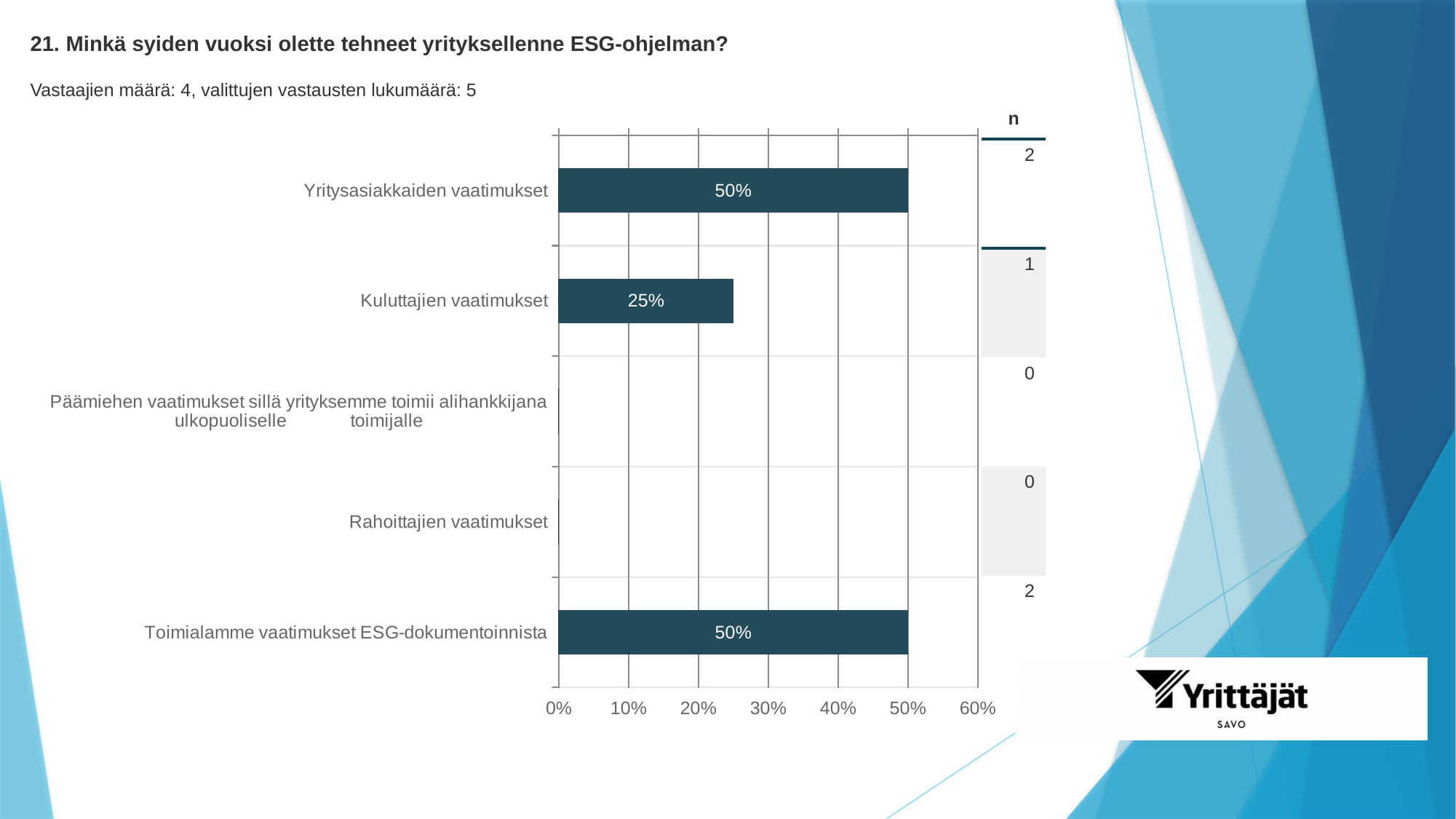
What percentage is shown for Toimialamme vaatimukset ESG-dokumentoinnista? 50% What is the n value shown for Kuluttajien vaatimukset? 1 What percentage is shown for Yritysasiakkaiden vaatimukset? 50% What is the title of the chart on the slide? 21. Minkä syiden vuoksi olette tehneet yrityksellenne ESG-ohjelman? What is the n value shown for Rahoittajien vaatimukset? 0 What is the difference between the values for Yritysasiakkaiden vaatimukset and Kuluttajien vaatimukset? 25% Which is larger, the value for Yritysasiakkaiden vaatimukset or the value for Kuluttajien vaatimukset? Yritysasiakkaiden vaatimukset What is the n value shown for Toimialamme vaatimukset ESG-dokumentoinnista? 2 How many categories are shown on the chart? 5 What kind of chart is shown on the slide? Bar chart Is the value for Kuluttajien vaatimukset greater or less than 30%? less What percentage is shown for Kuluttajien vaatimukset? 25%